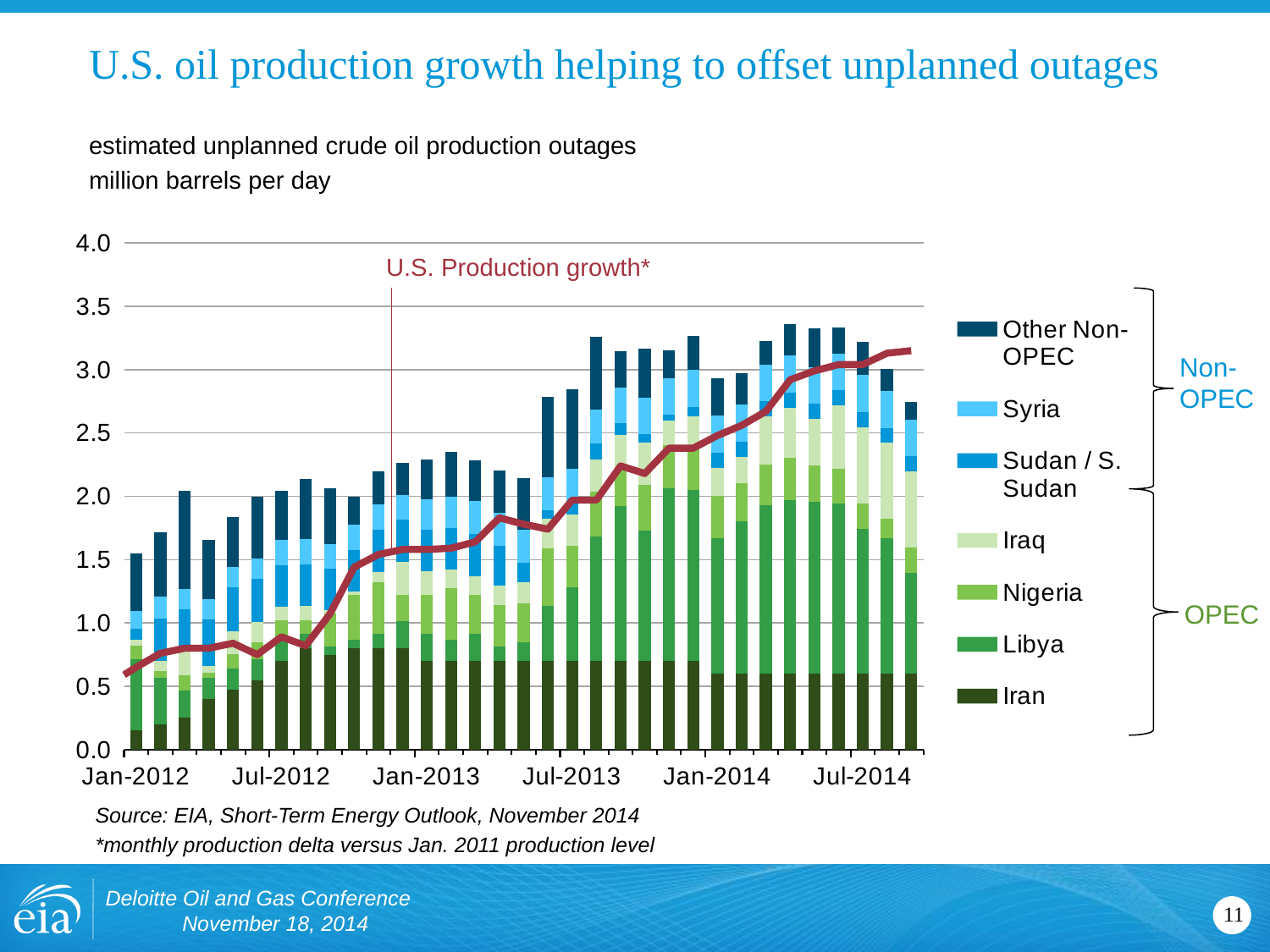
Is the total unplanned outage in Jan-2012 greater or less than 2.0? less How many series does the legend list? 7 Which is larger, the Iran segment in Jan-2012 or in Jul-2014? Jul-2014 What kind of chart is shown on the slide? Stacked bar chart with a line Is the total unplanned outage in Jan-2013 greater or less than 2.0? greater Is the U.S. Production growth line in Jan-2012 greater or less than 1.0? less Does the U.S. Production growth line generally rise or fall from Jan-2012 to Jul-2014? rise Which is larger, the total unplanned outage in Jan-2012 or in Jul-2014? Jul-2014 What unit is the chart measured in? million barrels per day Which series is listed at the bottom of the legend? Iran